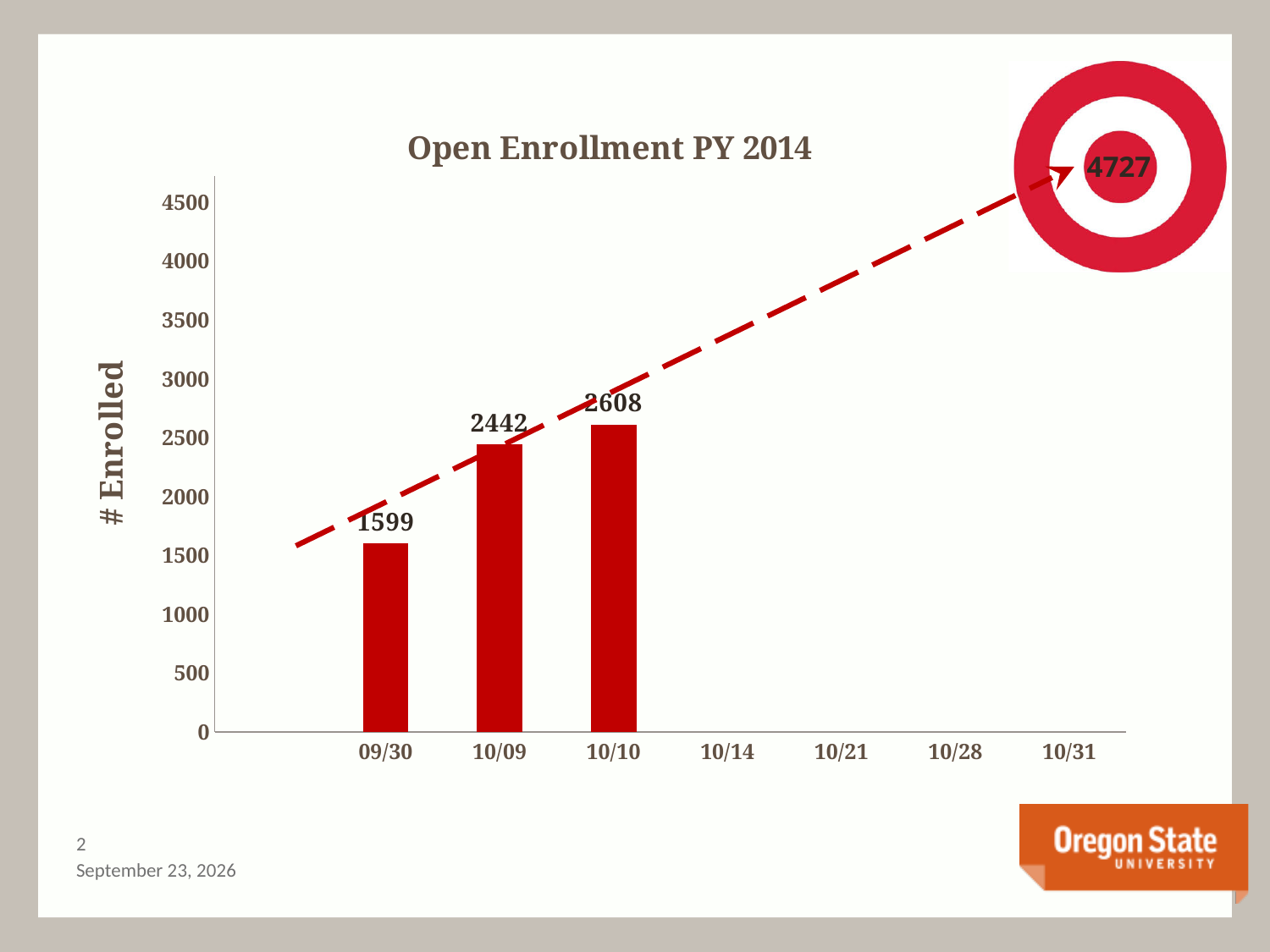
Which date has the highest number enrolled among the plotted bars? 10/10 What is the difference between the values for 10/09 and 09/30? 843 What is the value for 10/10? 2608 What is the value for 10/09? 2442 How many dates have a bar plotted on the chart? 3 Which is larger, the value for 10/09 or the value for 10/10? 10/10 What kind of chart is this? bar chart What is the difference between the values for 10/10 and 09/30? 1009 What is the title of the chart? Open Enrollment PY 2014 Is the value for 09/30 greater or less than 2000? less What is the value for 09/30? 1599 Which date has the lowest number enrolled among the plotted bars? 09/30